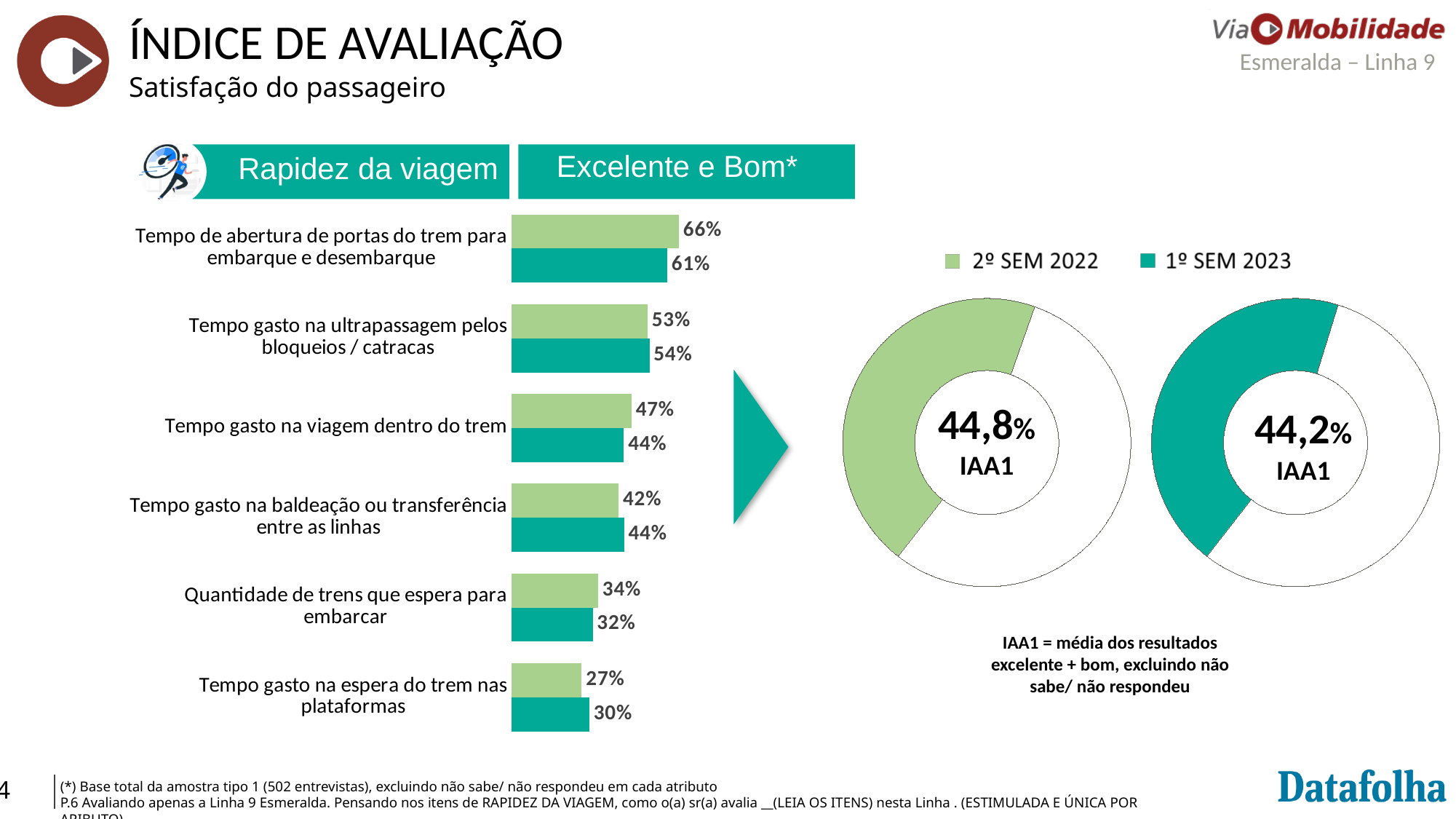
How many categories does the bar chart show? 6 In the bar chart, what is the difference between the 2º SEM 2022 and 1º SEM 2023 values for "Tempo de abertura de portas do trem para embarque e desembarque"? 5% In the bar chart, which category has the highest 2º SEM 2022 value? Tempo de abertura de portas do trem para embarque e desembarque In the bar chart, what is the 2º SEM 2022 value for "Tempo gasto na espera do trem nas plataformas"? 27% In the bar chart, what is the 1º SEM 2023 value for "Tempo de abertura de portas do trem para embarque e desembarque"? 61% What kind of chart is used for the "Rapidez da viagem" attributes on the left? Bar chart In the bar chart, which category has the lowest 1º SEM 2023 value? Tempo gasto na espera do trem nas plataformas In the donut chart on the right for 1º SEM 2023, what is the IAA1 value? 44,2% In the bar chart, what is the 1º SEM 2023 value for "Quantidade de trens que espera para embarcar"? 32% What is the difference between the IAA1 values shown in the two donut charts (2º SEM 2022 minus 1º SEM 2023)? 0,6% In the bar chart, for "Tempo gasto na baldeação ou transferência entre as linhas", which is larger: the 2º SEM 2022 value or the 1º SEM 2023 value? 1º SEM 2023 How many series does the legend list? 2